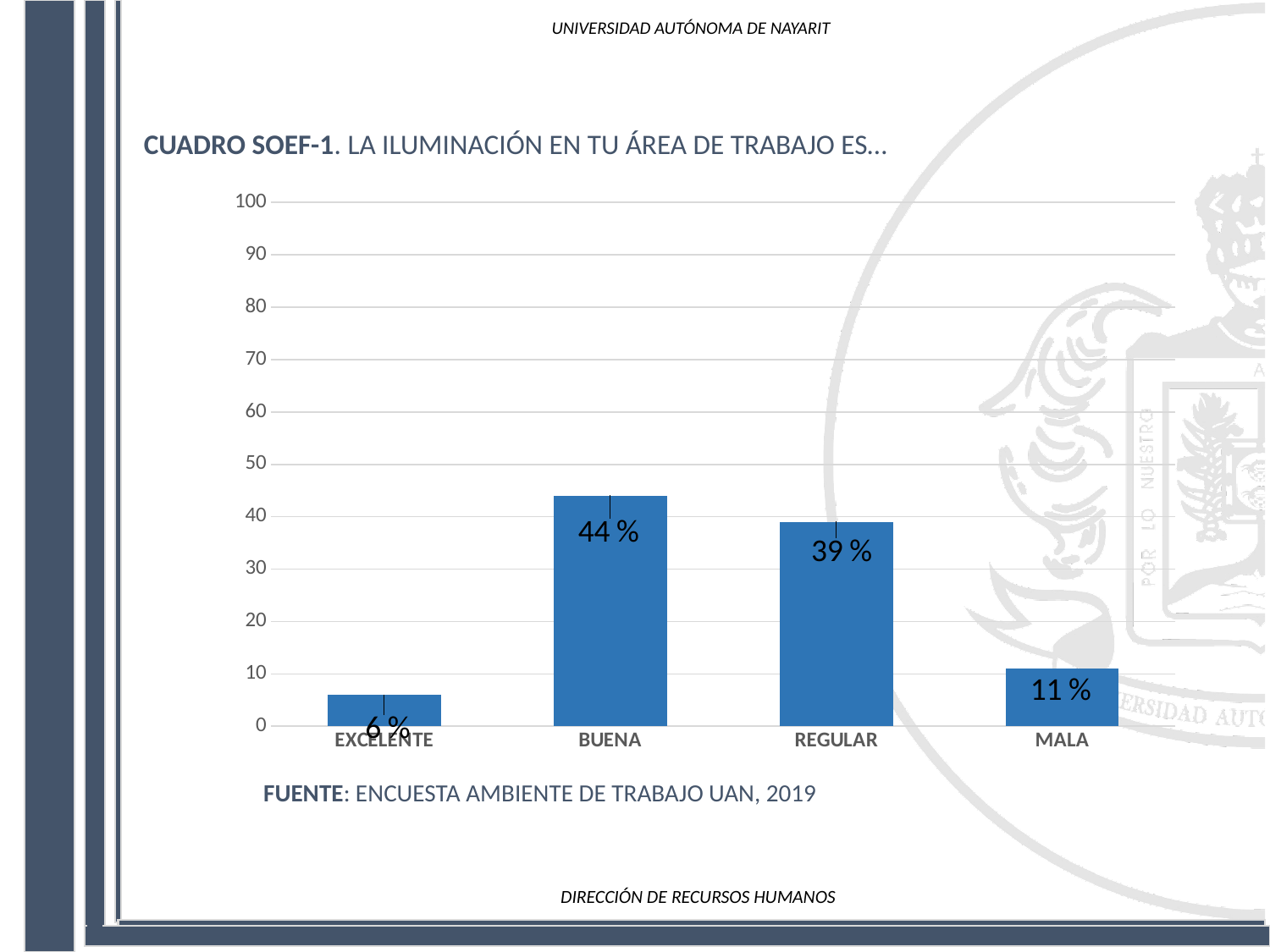
How many categories are shown on the x axis? 4 Which category has the lowest value? EXCELENTE Is the value for REGULAR greater or less than 50? less What is the value for BUENA? 44 % What is the value for EXCELENTE? 6 % What kind of chart is shown on the slide? bar chart What is the difference between the values for BUENA and REGULAR? 5 % Which category has the highest value? BUENA What is the value for REGULAR? 39 % What is the source cited below the chart? ENCUESTA AMBIENTE DE TRABAJO UAN, 2019 What is the value for MALA? 11 % Which is larger, the value for MALA or the value for EXCELENTE? MALA